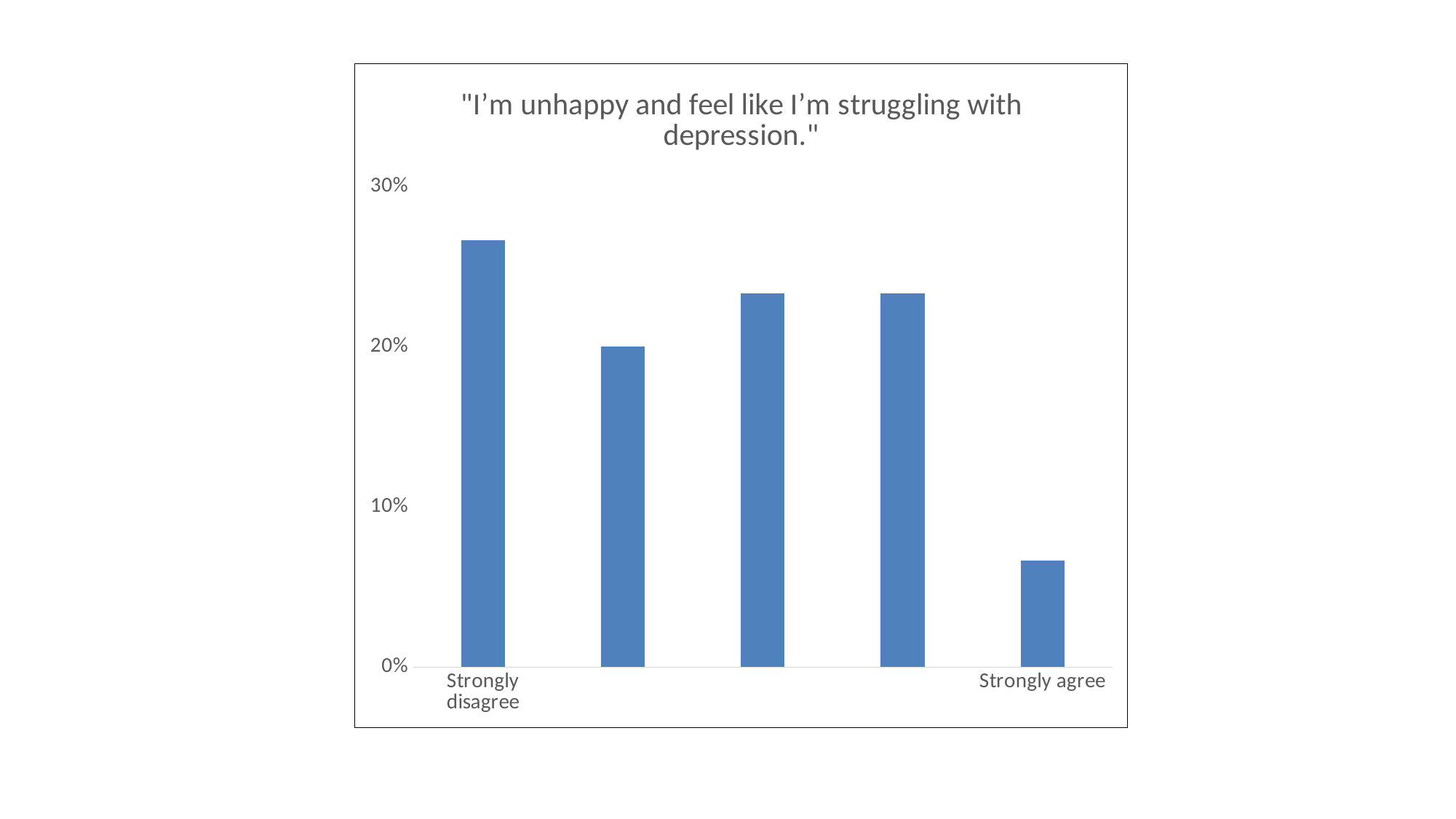
What is the highest value shown on the vertical axis? 30% Is the value for Strongly agree greater or less than 10%? less Is the value for Strongly disagree greater or less than 30%? less What kind of chart is shown on the slide? bar chart Is the value for Strongly disagree greater or less than 20%? greater How many bars are plotted in the chart? 5 Which category has the lowest bar? Strongly agree What is the title of the chart? "I'm unhappy and feel like I'm struggling with depression." Which is larger, the value for Strongly disagree or the value for Strongly agree? Strongly disagree Which category has the highest bar? Strongly disagree